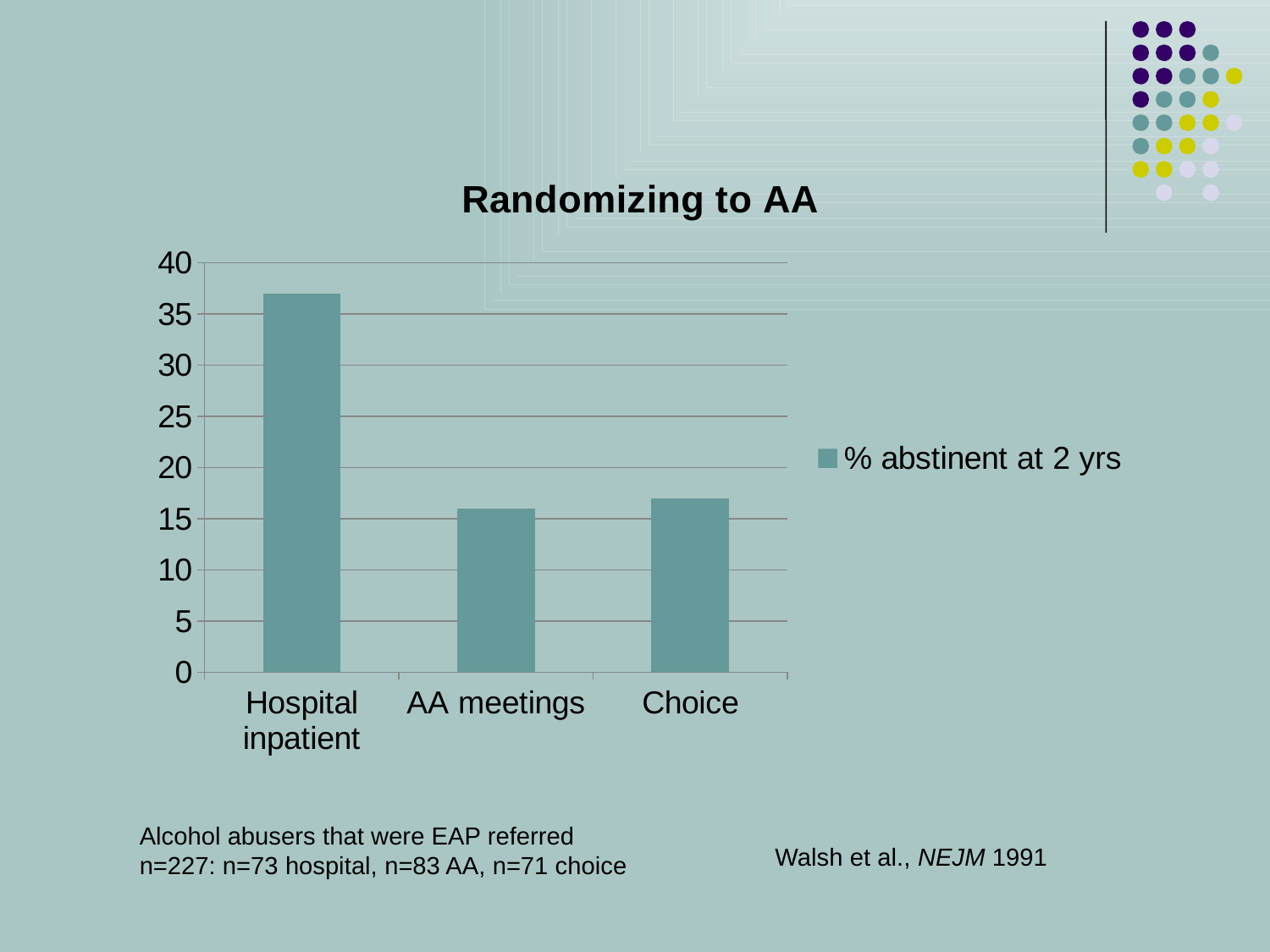
Is the value for Choice greater or less than 20? less Is the value for AA meetings greater or less than 20? less How many series does the legend list? 1 Is the value for Hospital inpatient greater or less than 35? greater How many categories are shown on the x axis? 3 What kind of chart is shown on the slide? bar chart What is the title of the chart? Randomizing to AA What is the name of the series shown in the legend? % abstinent at 2 yrs Which is larger, the value for Hospital inpatient or the value for Choice? Hospital inpatient Which category has the highest % abstinent at 2 yrs? Hospital inpatient